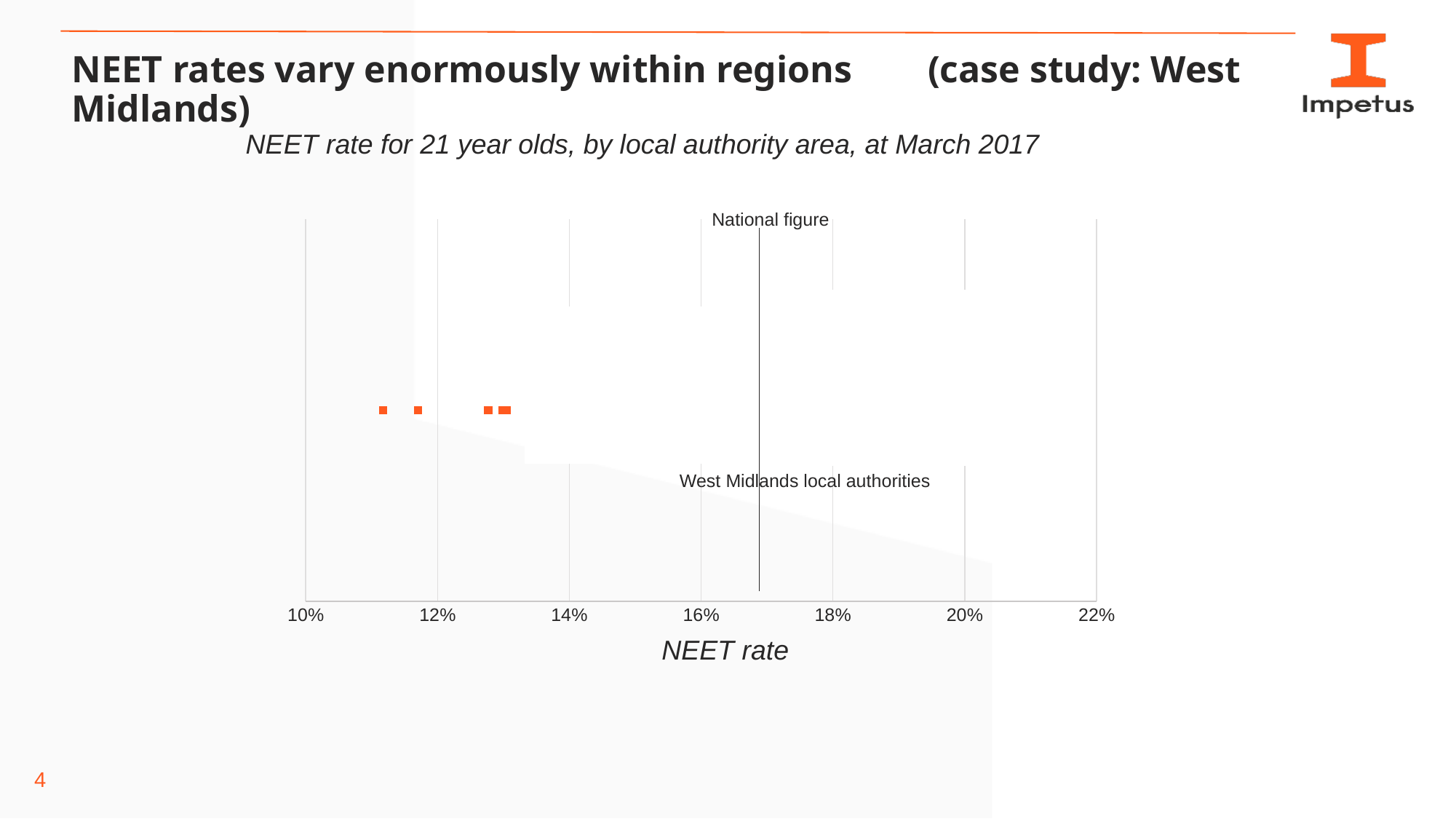
Do the West Midlands local authority markers lie to the left or to the right of the national figure line? left Are the West Midlands local authority markers greater or less than 10%? greater What is the label on the horizontal axis of the chart? NEET rate How many tick labels are shown on the horizontal axis? 7 What does the vertical black line on the chart represent? National figure What is the interval between consecutive tick labels on the horizontal axis? 2% Is the national figure line greater or less than 16%? greater What is the title of the chart? NEET rate for 21 year olds, by local authority area, at March 2017 Are the West Midlands local authority markers greater or less than 14%? less What is the highest value shown on the horizontal axis? 22% What is the lowest value shown on the horizontal axis? 10%